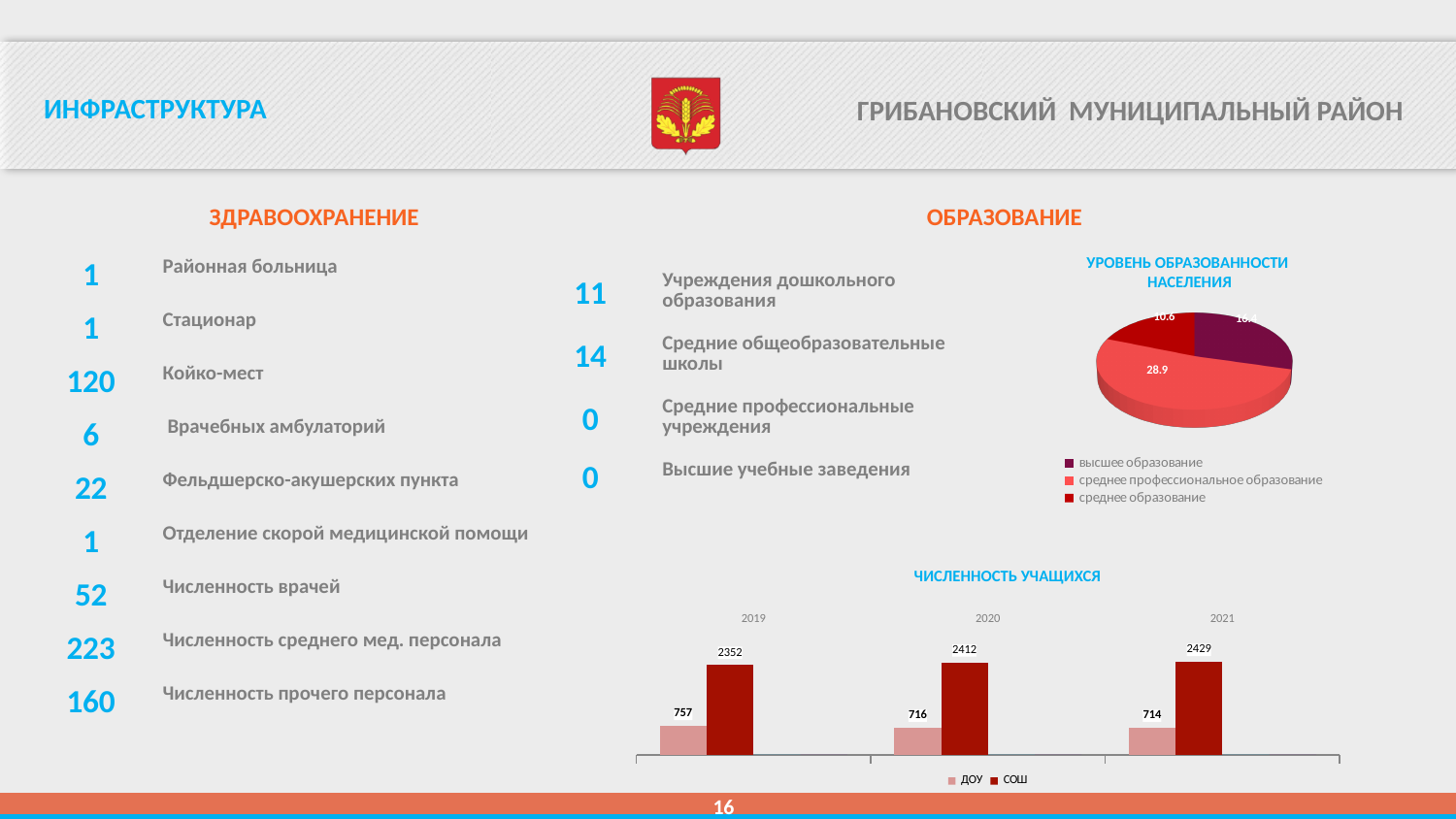
In the УРОВЕНЬ ОБРАЗОВАННОСТИ НАСЕЛЕНИЯ pie chart, which category has the largest slice? среднее профессиональное образование In the ЧИСЛЕННОСТЬ УЧАЩИХСЯ chart, which year has the lowest ДОУ value? 2021 In the ЧИСЛЕННОСТЬ УЧАЩИХСЯ chart, which is larger: ДОУ in 2020 or ДОУ in 2021? ДОУ in 2020 In the ЧИСЛЕННОСТЬ УЧАЩИХСЯ chart, how many years are shown on the x axis? 3 In the ЧИСЛЕННОСТЬ УЧАЩИХСЯ chart, what is the value for СОШ in 2020? 2412 In the ЧИСЛЕННОСТЬ УЧАЩИХСЯ chart, do the ДОУ values rise or fall from 2019 to 2021? Fall In the ЧИСЛЕННОСТЬ УЧАЩИХСЯ chart, what is the value for СОШ in 2021? 2429 In the ЧИСЛЕННОСТЬ УЧАЩИХСЯ chart, which year has the highest СОШ value? 2021 In the ЧИСЛЕННОСТЬ УЧАЩИХСЯ chart, how many series does the legend list? 2 What kind of chart is the ЧИСЛЕННОСТЬ УЧАЩИХСЯ chart? Bar chart In the ЧИСЛЕННОСТЬ УЧАЩИХСЯ chart, what is the value for ДОУ in 2019? 757 In the ЧИСЛЕННОСТЬ УЧАЩИХСЯ chart, what is the difference between the СОШ values for 2021 and 2019? 77